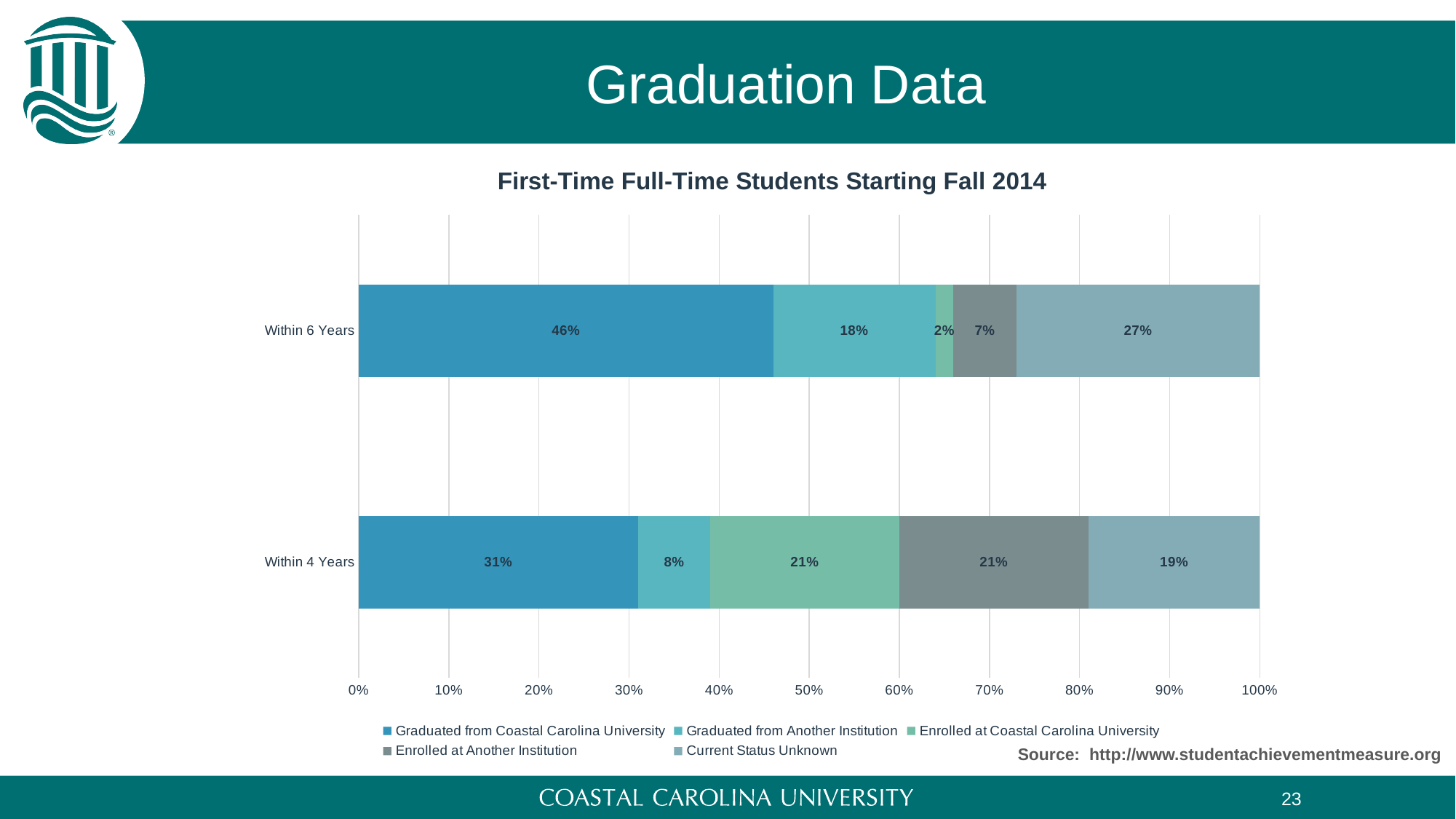
How many series does the legend list? 5 What is the value for Graduated from Another Institution in the Within 4 Years bar? 8% What is the title of the chart? First-Time Full-Time Students Starting Fall 2014 What percentage of students graduated from Coastal Carolina University within 4 years? 31% What kind of chart is shown on the slide? Stacked bar chart Which series has the smallest value in the Within 6 Years bar? Enrolled at Coastal Carolina University What is the value for Enrolled at Another Institution in the Within 4 Years bar? 21% What is the difference between the Graduated from Coastal Carolina University values for Within 6 Years and Within 4 Years? 15% What is the value for Current Status Unknown in the Within 6 Years bar? 27% Which is larger: Current Status Unknown for Within 6 Years or for Within 4 Years? Within 6 Years How many categories are shown on the vertical axis? 2 What percentage of students graduated from Coastal Carolina University within 6 years? 46%